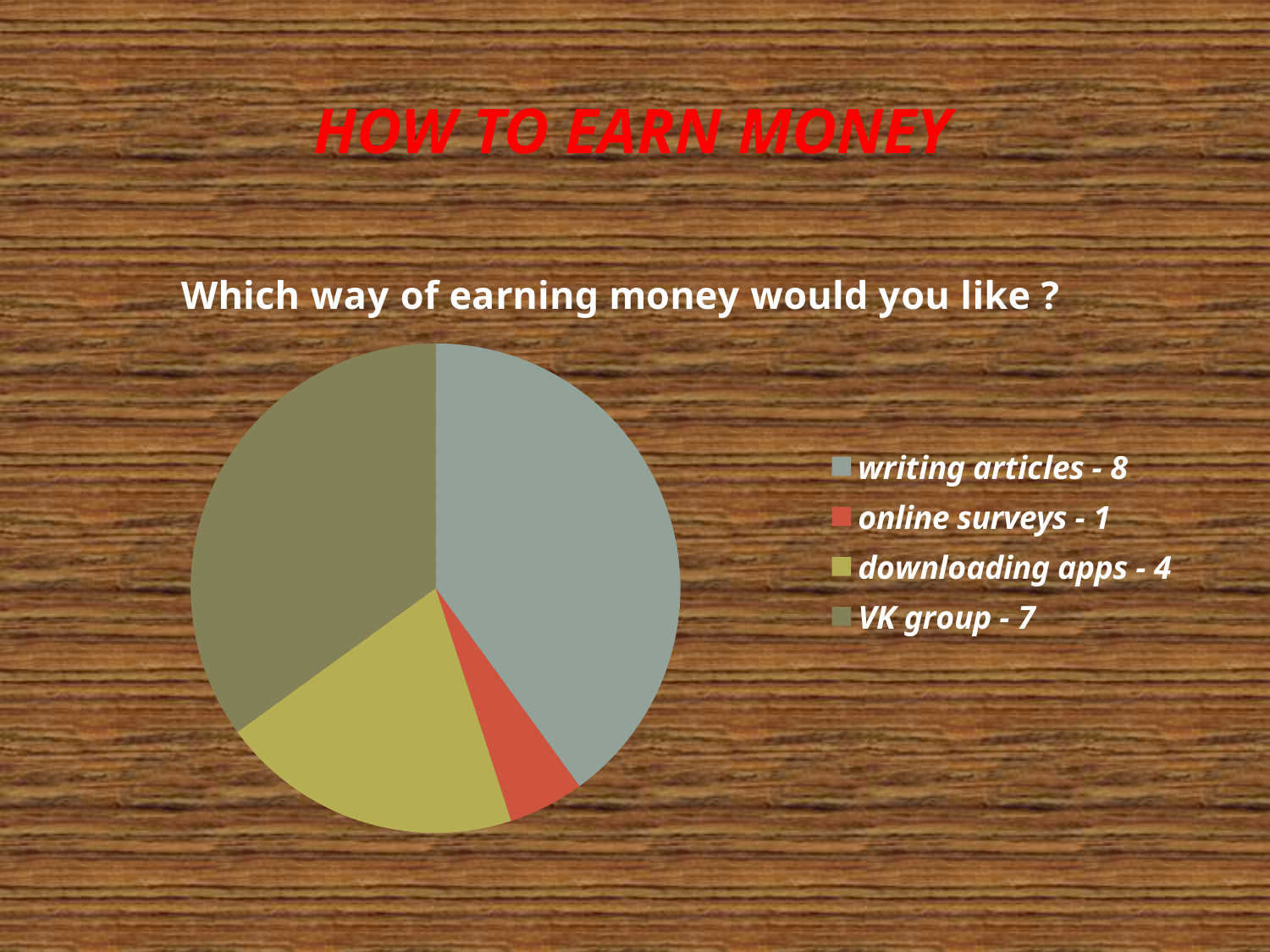
What is the value for downloading apps? 4 What kind of chart is shown on the slide? pie chart What is the value for VK group? 7 Which way of earning money has the highest value? writing articles What share of the pie does writing articles represent? 40% What is the value for online surveys? 1 Which is larger, the value for VK group or the value for downloading apps? VK group Which way of earning money has the lowest value? online surveys What is the difference between the values for writing articles and downloading apps? 4 What is the value for writing articles? 8 What question is the pie chart answering, according to the text above it? Which way of earning money would you like ? How many slices does the pie chart have? 4